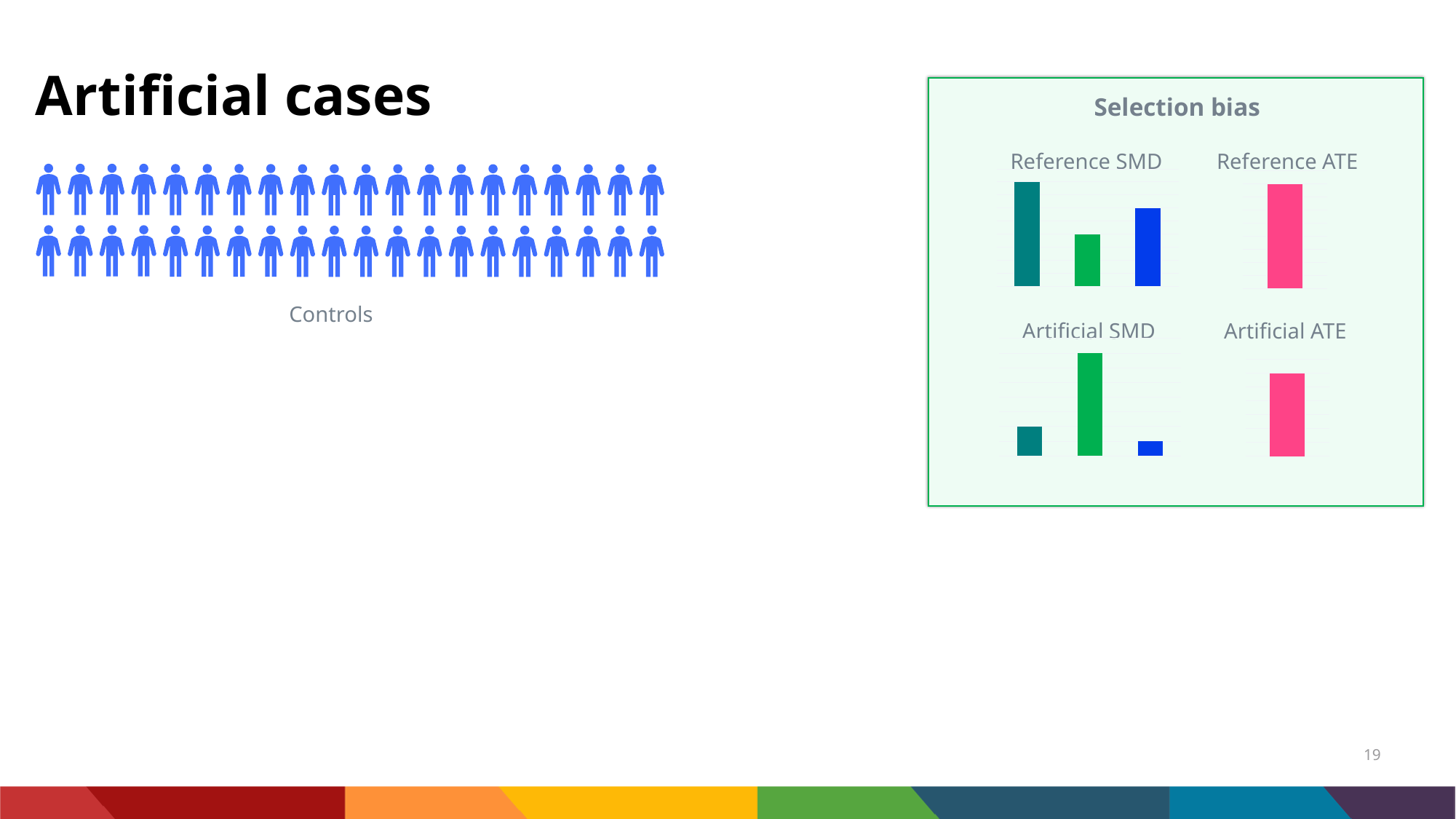
In the "Reference SMD" chart, which bar is the shortest: the teal (left), green (middle) or blue (right) bar? green (middle) In the "Artificial SMD" chart, which is taller: the teal (left) bar or the blue (right) bar? teal (left) What colour are the bars in the "Reference ATE" and "Artificial ATE" charts? pink How many bars does the "Reference ATE" chart show? 1 How many bars does the "Artificial SMD" chart show? 3 In the "Artificial SMD" chart, which bar is the tallest: the teal (left), green (middle) or blue (right) bar? green (middle) How many bars does the "Reference SMD" chart show? 3 In the "Reference SMD" chart, which bar is the tallest: the teal (left), green (middle) or blue (right) bar? teal (left) Which is taller: the bar in the "Reference ATE" chart or the bar in the "Artificial ATE" chart? Reference ATE In the "Artificial SMD" chart, which bar is the shortest: the teal (left), green (middle) or blue (right) bar? blue (right) What is the title of the green-bordered panel containing the four small charts? Selection bias What kind of chart is the "Reference SMD" chart in the Selection bias panel? bar chart